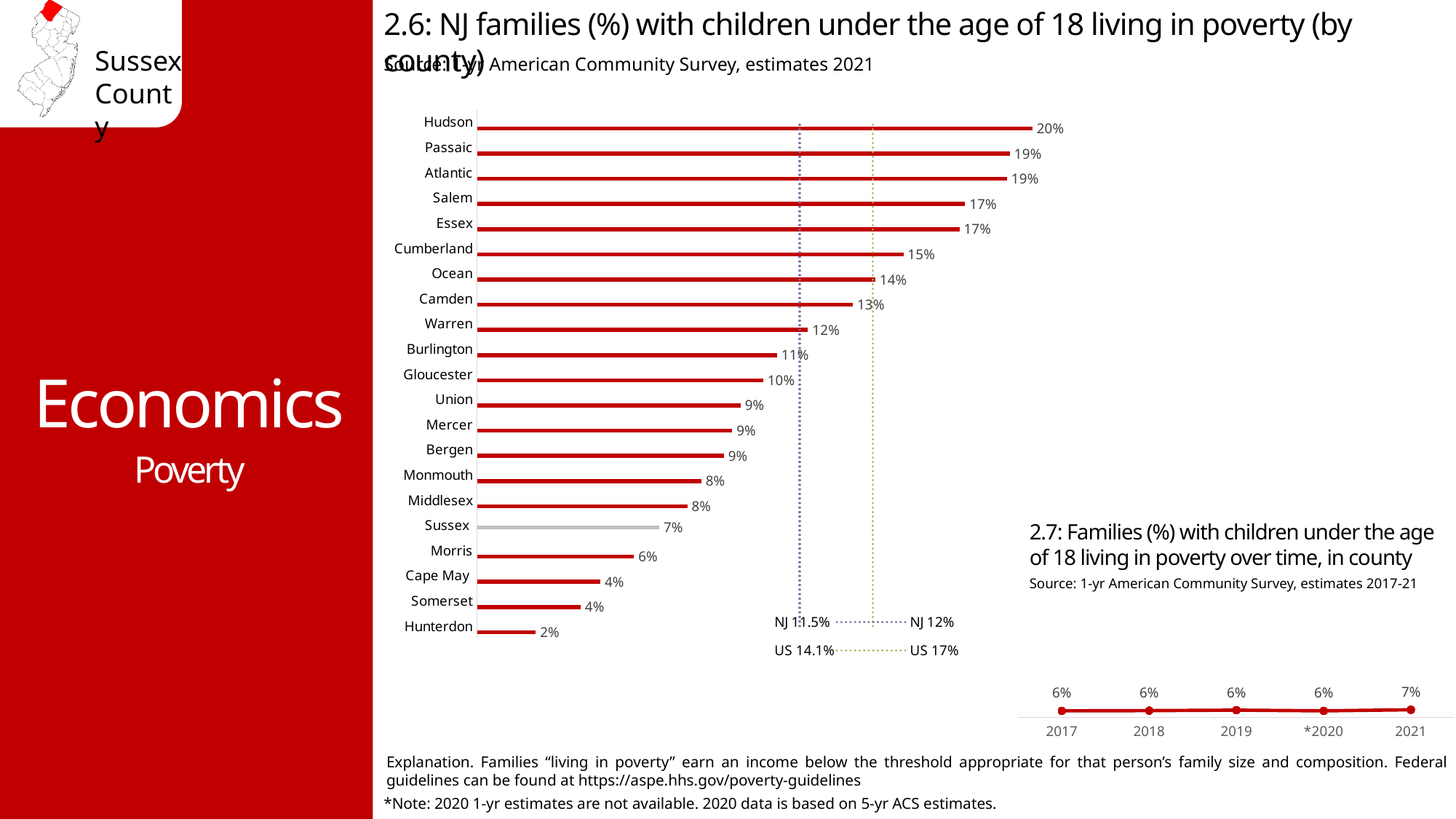
In chart 2.6, which is larger, the value for Camden or the value for Warren? Camden In chart 2.7, how many years are plotted? 5 What kind of chart is chart 2.6? Bar chart In chart 2.6, what is the value for Sussex? 7% In chart 2.7, what is the value for 2021? 7% In chart 2.6, what NJ value is marked by the dotted reference line labelled NJ? 11.5% In chart 2.6, what is the value for Cumberland? 15% In chart 2.6, which county has the lowest value? Hunterdon In chart 2.6, how many counties are plotted? 21 In chart 2.6, which county has the highest value? Hudson In chart 2.6, what is the difference between the values for Hudson and Sussex? 13% In chart 2.7, do the values rise, fall, or stay flat from 2017 to 2021? Stay flat, then rise in 2021